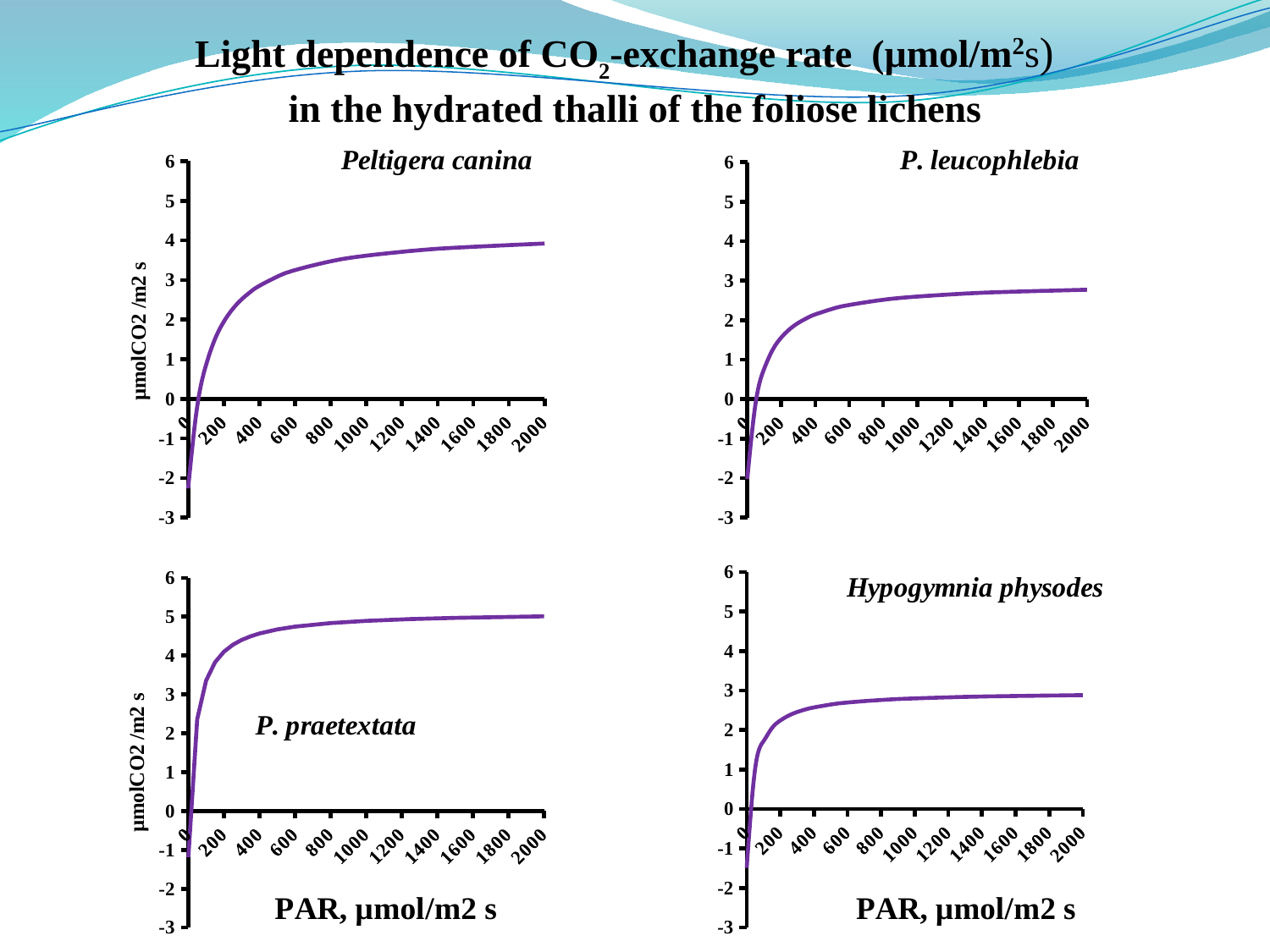
What is the x-axis label shown under the Hypogymnia physodes chart (bottom right)? PAR, µmol/m2 s What is the highest tick value shown on the x axis of the P. praetextata chart (bottom left)? 2000 In the Hypogymnia physodes chart (bottom right), is the value at PAR 2000 greater or less than 2? greater In the Hypogymnia physodes chart (bottom right), is the value at PAR 0 greater or less than 0? less In the P. praetextata chart (bottom left), is the value at PAR 2000 greater or less than 4? greater In the Peltigera canina chart (top left), does the CO2-exchange rate rise or fall as PAR increases along the x axis? rise What kind of chart is the Peltigera canina chart (top left)? line chart How many charts are shown on the slide? 4 Which species reaches a higher CO2-exchange rate at PAR 2000: P. praetextata (bottom left) or P. leucophlebia (top right)? P. praetextata